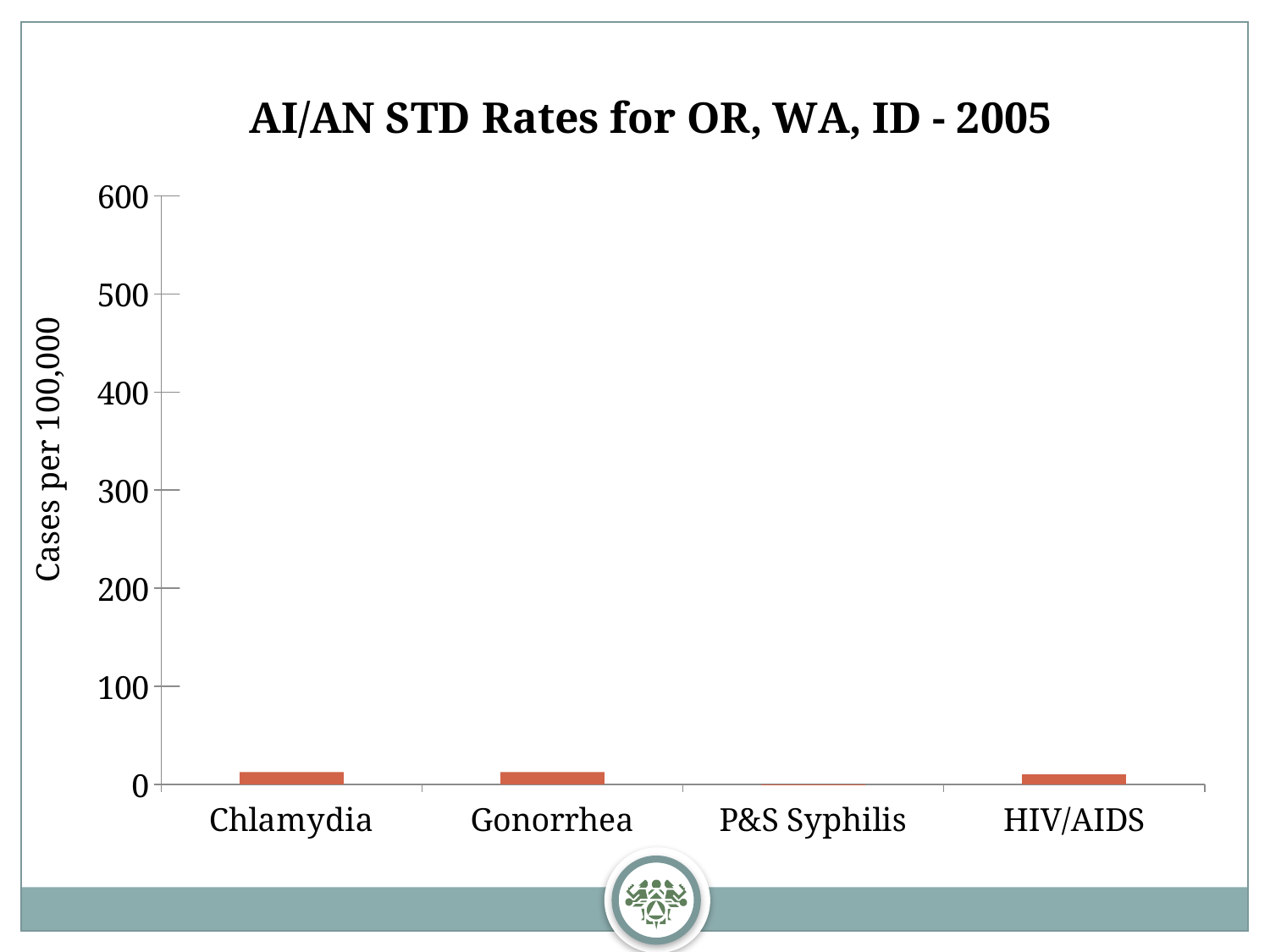
Is the value for Chlamydia greater or less than 100? less Which category has the lowest value in the chart? P&S Syphilis Is the value for Gonorrhea greater or less than 100? less Which is larger, the value for HIV/AIDS or the value for P&S Syphilis? HIV/AIDS Which is larger, the value for Chlamydia or the value for P&S Syphilis? Chlamydia Is the value for P&S Syphilis greater or less than 100? less What kind of chart is shown on the slide? bar chart What is the title of the chart? AI/AN STD Rates for OR, WA, ID - 2005 What is the label on the vertical axis of the chart? Cases per 100,000 What is the highest value shown on the vertical axis of the chart? 600 How many categories are shown on the x axis of the chart? 4